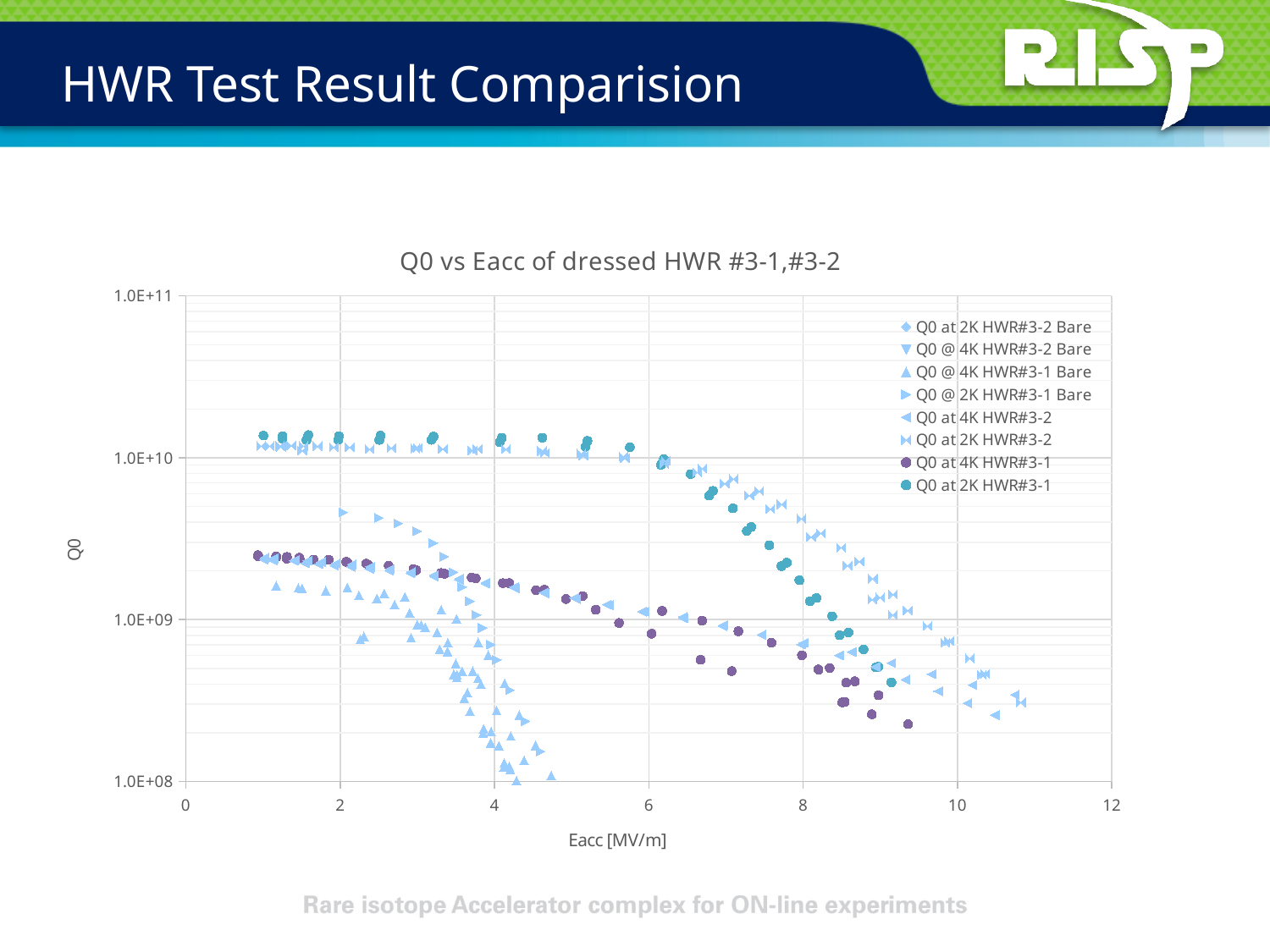
Do the Q0 values for the series 'Q0 at 2K HWR#3-2' rise or fall as Eacc increases from 6 to 10 MV/m? fall Is the Q0 value for 'Q0 at 2K HWR#3-1' at Eacc of 2 MV/m greater or less than 1.0E+10? greater Do the Q0 values for the series 'Q0 at 4K HWR#3-1' rise or fall as Eacc increases? fall What is the label of the x axis? Eacc [MV/m] Is the Q0 value for 'Q0 at 4K HWR#3-1' at Eacc of 2 MV/m greater or less than 1.0E+10? less What kind of chart is shown on the slide? scatter chart How many series does the chart legend list? 8 At Eacc of 2 MV/m, which series has the larger Q0: 'Q0 at 2K HWR#3-1' or 'Q0 at 4K HWR#3-1'? Q0 at 2K HWR#3-1 Is the Q0 value for 'Q0 at 2K HWR#3-2' at Eacc of 10 MV/m greater or less than 1.0E+09? less What is the title of the chart? Q0 vs Eacc of dressed HWR #3-1,#3-2